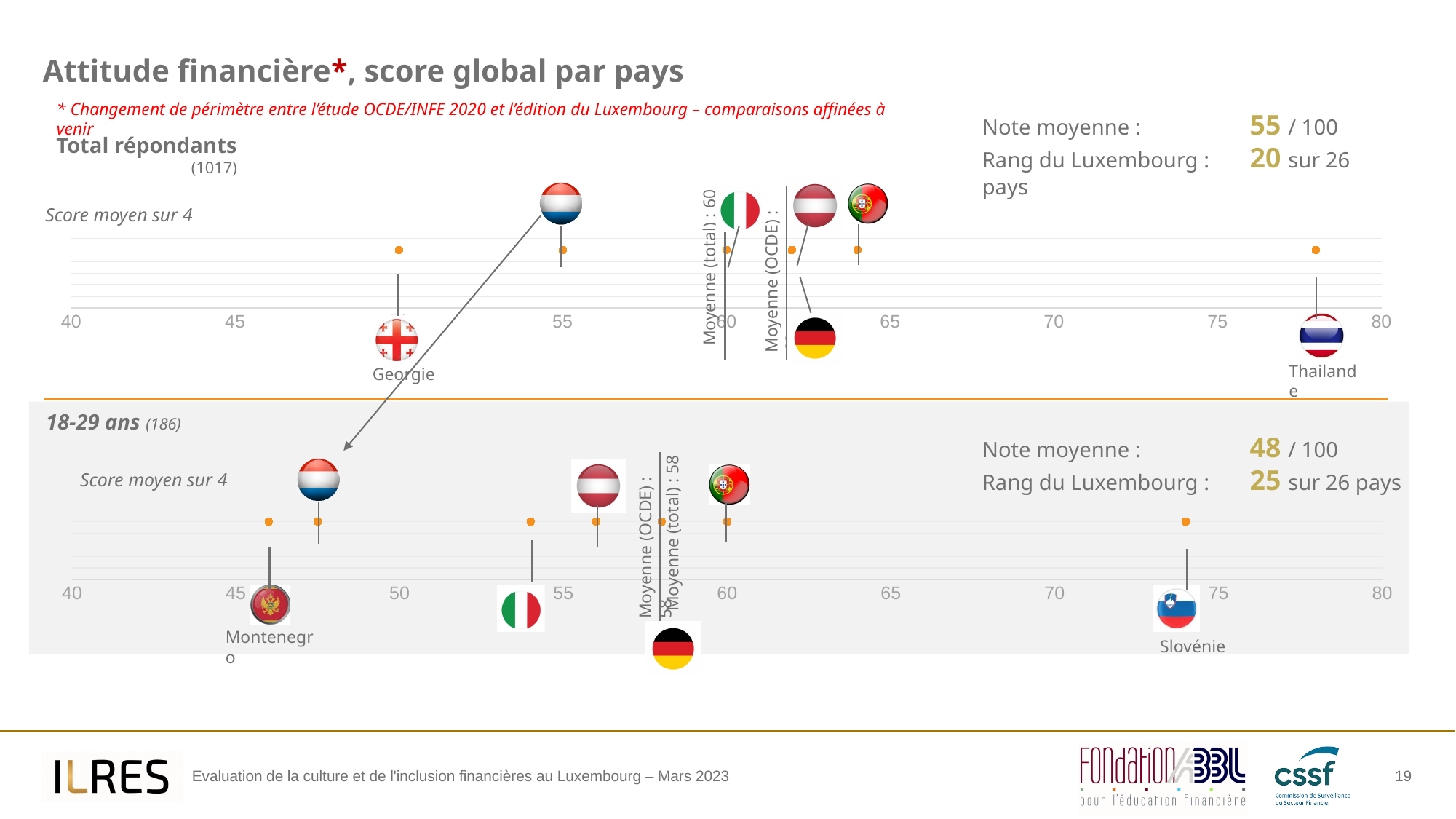
In the '18-29 ans' chart, what is the Rang du Luxembourg? 25 sur 26 pays In the '18-29 ans' chart, which labelled country has the lowest score? Montenegro In the 'Total répondants' chart, what is the Note moyenne for Luxembourg? 55 / 100 In the '18-29 ans' chart, what is the Note moyenne for Luxembourg? 48 / 100 In the 'Total répondants' chart, what is the Rang du Luxembourg? 20 sur 26 pays In the 'Total répondants' chart, what is the value of the Moyenne (total) line? 60 In the 'Total répondants' chart, is the value for Thailande greater or less than 75? greater In the '18-29 ans' chart, is the value for Slovénie greater or less than 70? greater In the '18-29 ans' chart, what is the value of the Moyenne (total) line? 58 In the 'Total répondants' chart, which labelled country has the highest score? Thailande In the 'Total répondants' chart, what are the minimum and maximum values shown on the horizontal axis? 40 and 80 In the 'Total répondants' chart, which labelled country has the lowest score? Georgie